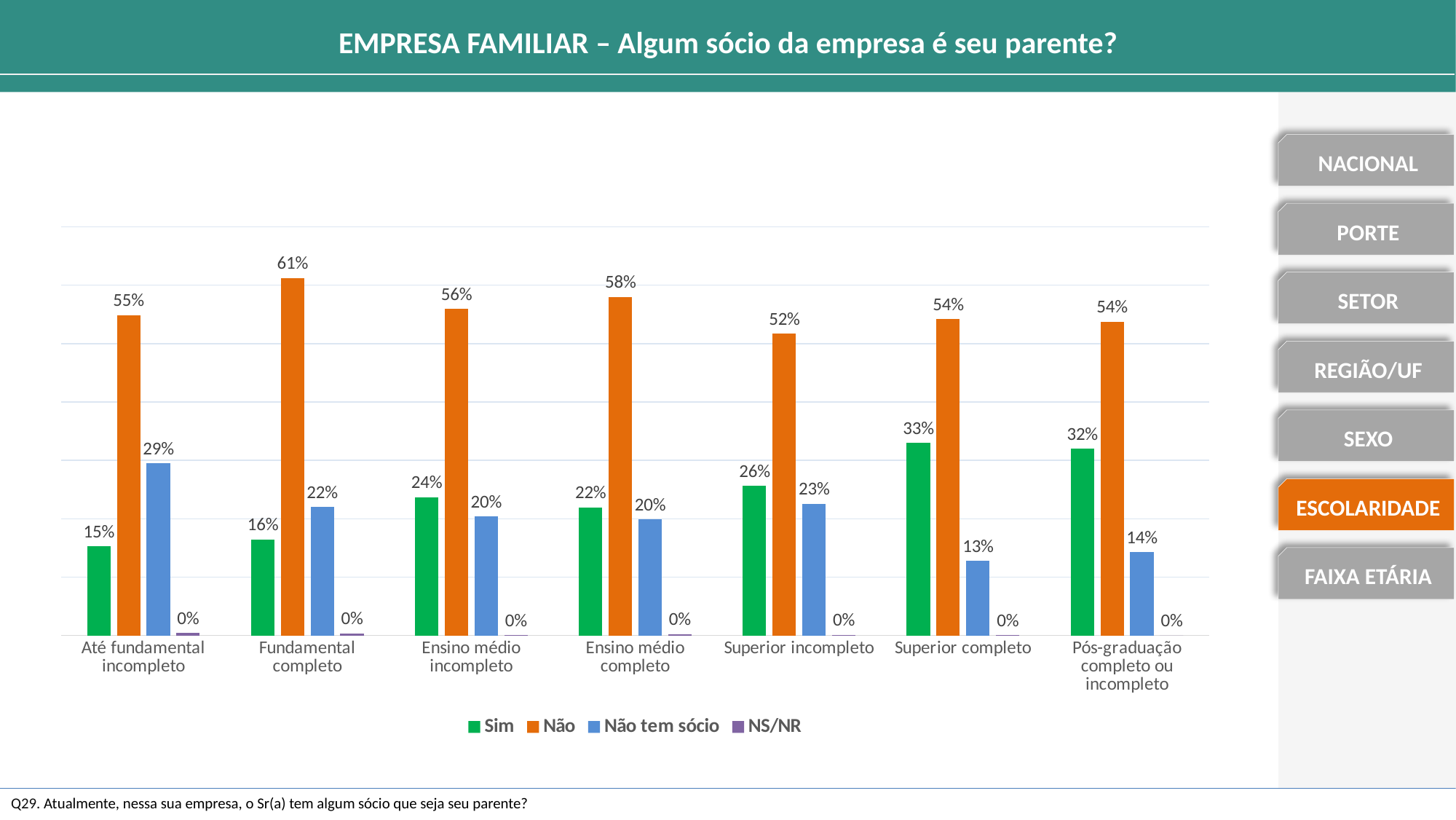
What is the value of "Sim" for "Superior completo"? 33% How many series does the legend list? 4 Which series is shown in orange in the legend? Não How many education categories are shown on the x axis? 7 Which category has the lowest value for "Sim"? Até fundamental incompleto Does the value of "Não tem sócio" rise or fall from "Superior incompleto" to "Superior completo"? Fall Which is larger for "Superior incompleto": "Sim" or "Não tem sócio"? Sim What is the value of "Não tem sócio" for "Até fundamental incompleto"? 29% Which category has the highest value for "Não"? Fundamental completo What is the value of "Não" for "Fundamental completo"? 61% What is the difference between "Não" and "Sim" for "Ensino médio completo"? 36 percentage points What kind of chart is shown on the slide? Bar chart